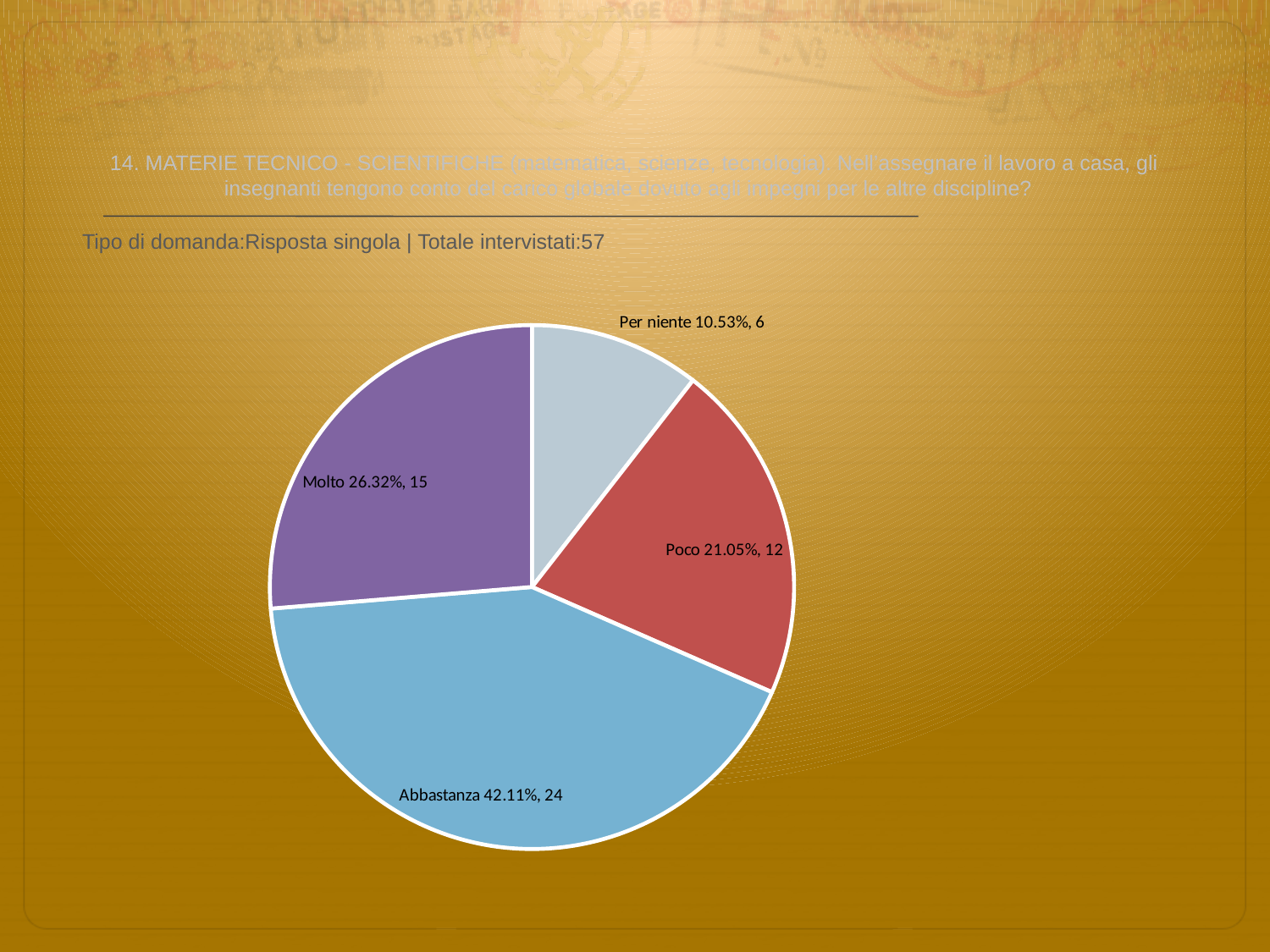
Which has a larger count, 'Poco' or 'Molto'? Molto What kind of chart is shown on the slide? pie chart What percentage share does the 'Molto' slice have? 26.32% What colour is the 'Abbastanza' slice? light blue Which slice is the smallest? Per niente What is the difference in count between 'Abbastanza' and 'Molto'? 9 How many slices does the pie chart have? 4 What percentage share does the 'Poco' slice have? 21.05% What is the count for the 'Abbastanza' slice? 24 Which slice is the largest? Abbastanza What is the total number of respondents across all slices? 57 What is the count for the 'Per niente' slice? 6